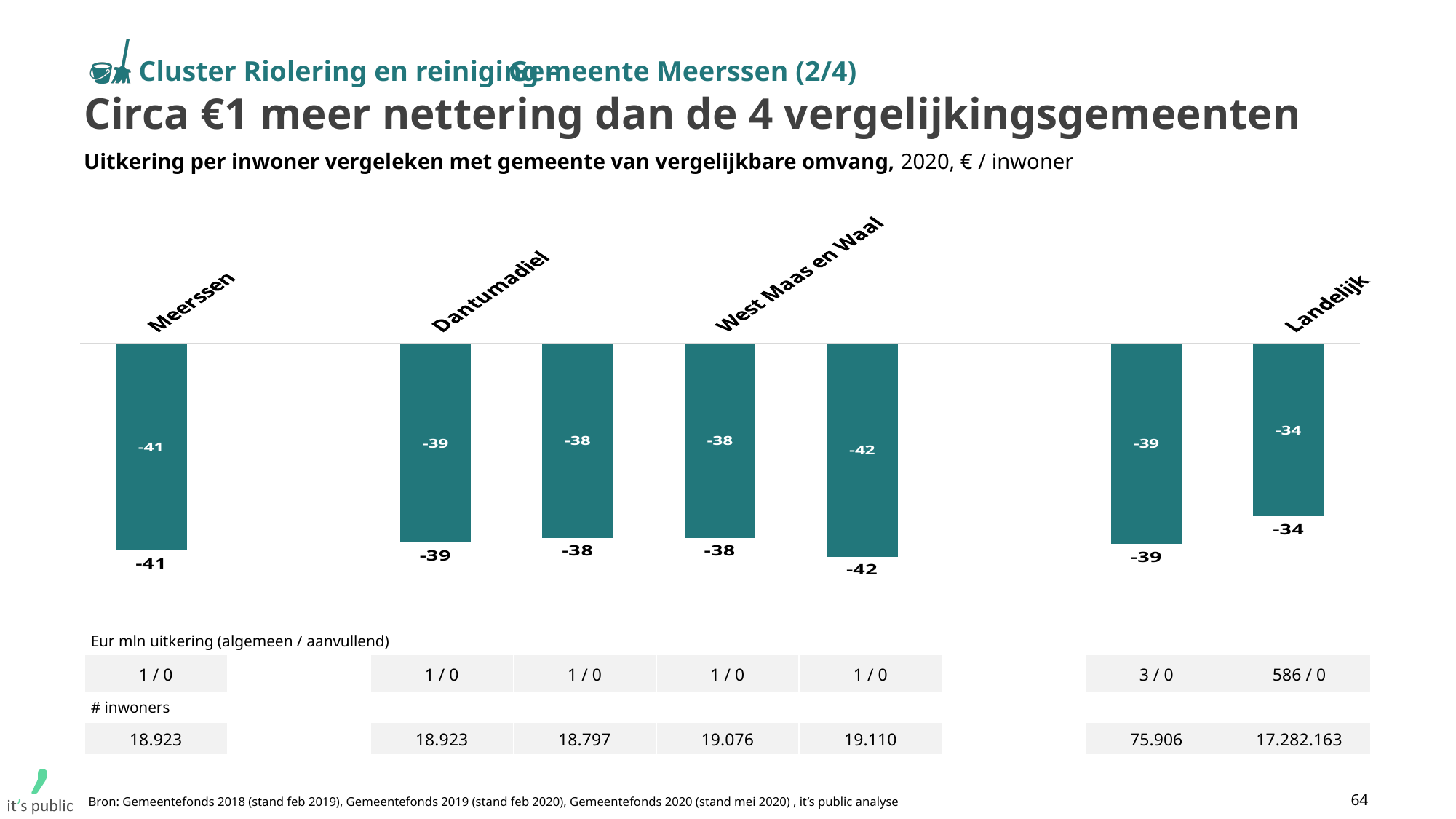
What unit is stated in the chart subtitle? € / inwoner What is the number of inwoners listed for Meerssen in the table below the chart? 18.923 Which category has the highest (least negative) value? Landelijk What is the difference between the values for Meerssen and Landelijk? 7 What is the value for Landelijk? -34 Which value is higher, Meerssen or West Maas en Waal? West Maas en Waal What is the value for Meerssen? -41 What is the difference between the values for Meerssen and Dantumadiel? 2 How many bars are plotted in the chart? 7 What is the value for Dantumadiel? -39 What is the value for West Maas en Waal? -38 What kind of chart is shown on the slide? Bar chart